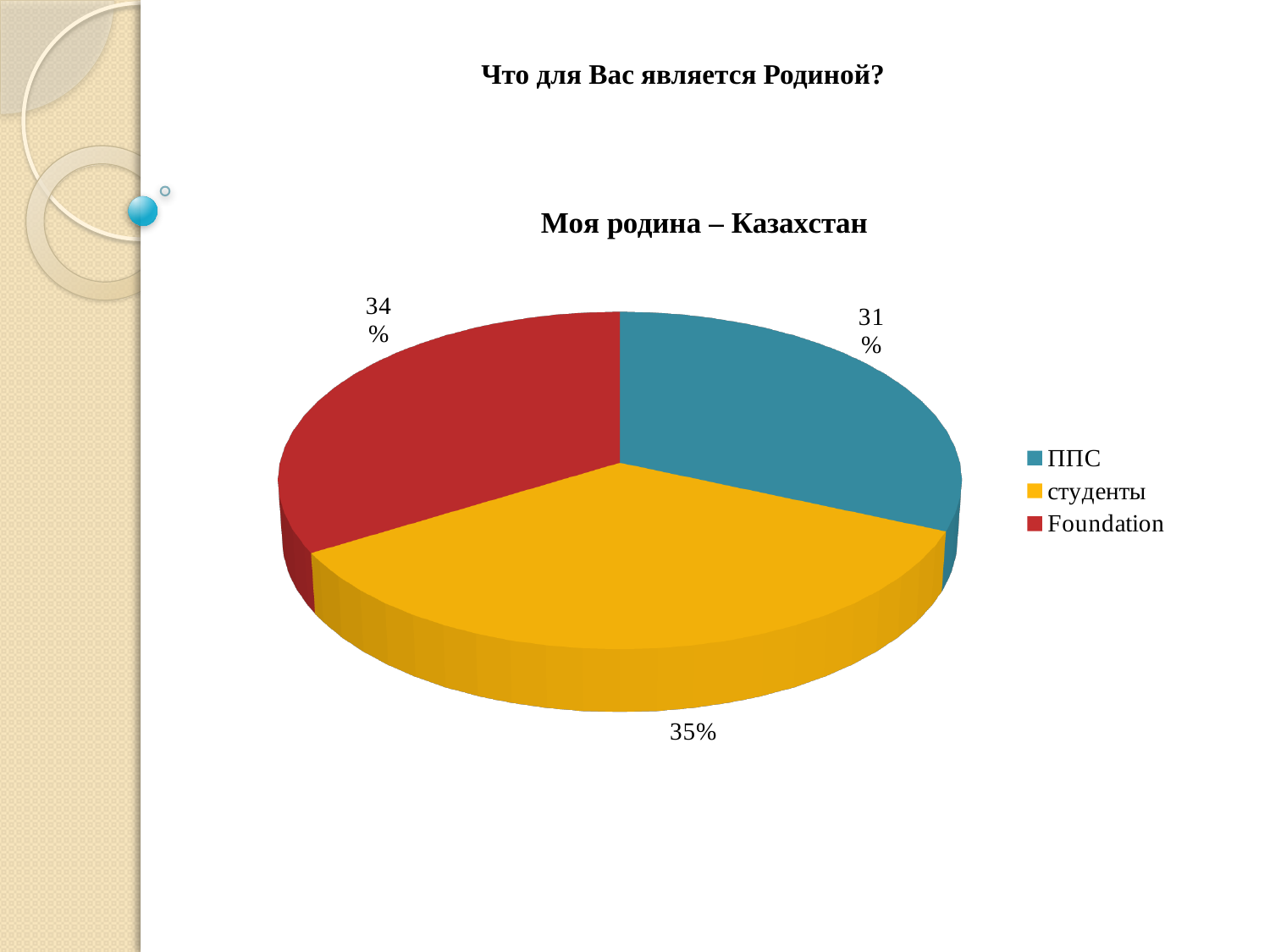
Which group has the largest slice of the pie? студенты What kind of chart is shown on the slide? Pie chart How many slices does the pie chart have? 3 Which colour represents Foundation in the chart? Red What percentage is shown for ППС? 31% How many entries does the legend list? 3 What percentage is shown for студенты? 35% What is the difference in percentage points between студенты and ППС? 4 Which is larger, the share for Foundation or the share for ППС? Foundation Which group has the smallest slice of the pie? ППС What is the chart's title? Моя родина – Казахстан What percentage is shown for Foundation? 34%